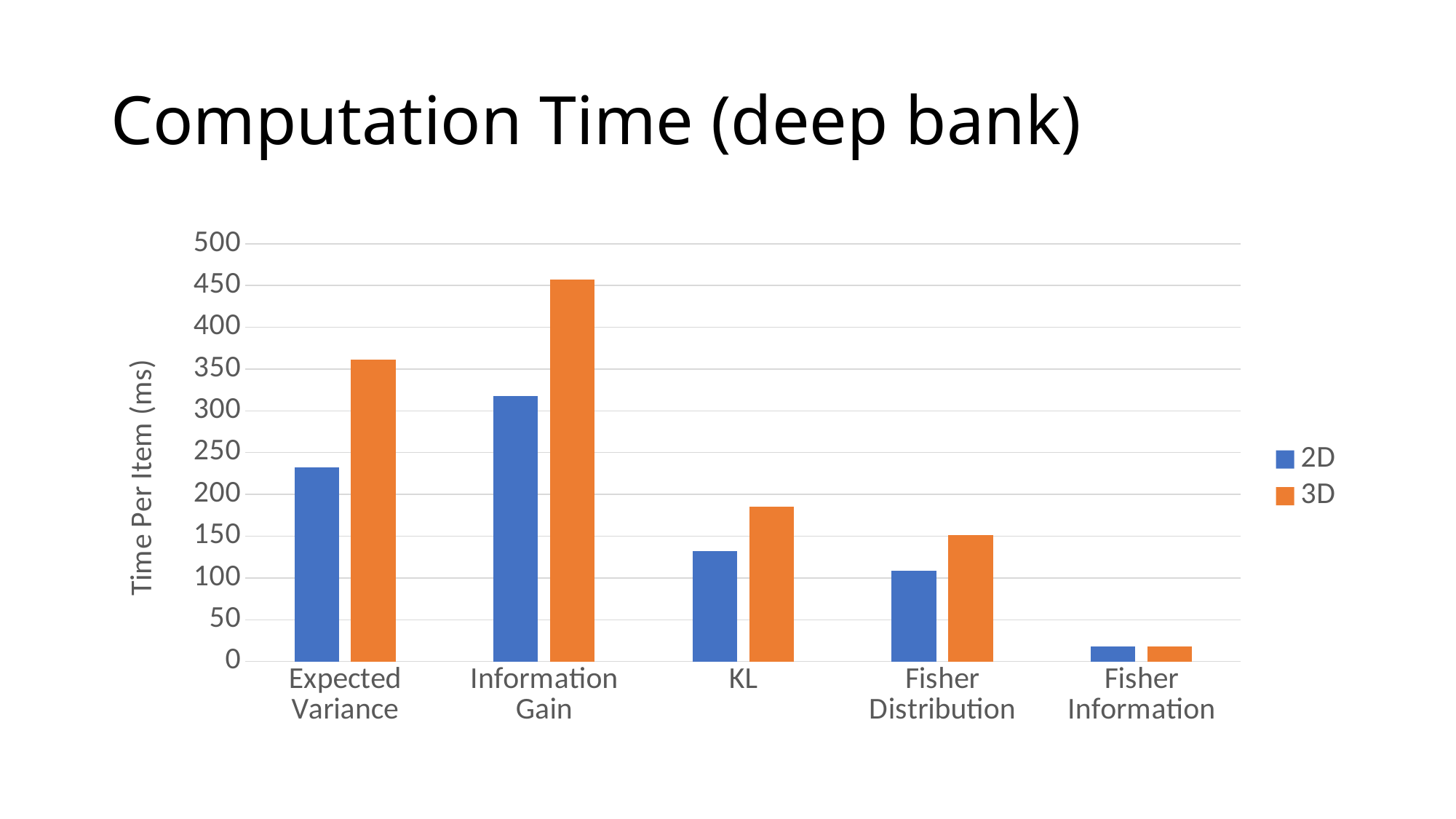
Is the 2D value for Expected Variance greater or less than 250? less How many series does the legend list? 2 Which category has the lowest 3D value? Fisher Information For Expected Variance, which series has the larger value, 2D or 3D? 3D Which has the larger 2D value, KL or Fisher Distribution? KL What is the label on the y axis? Time Per Item (ms) What kind of chart is shown on the slide? bar chart Which category has the highest 3D value? Information Gain Is the 3D value for KL greater or less than 150? greater Which category has the highest 2D value? Information Gain How many categories are shown on the x axis? 5 Is the 3D value for Information Gain greater or less than 400? greater